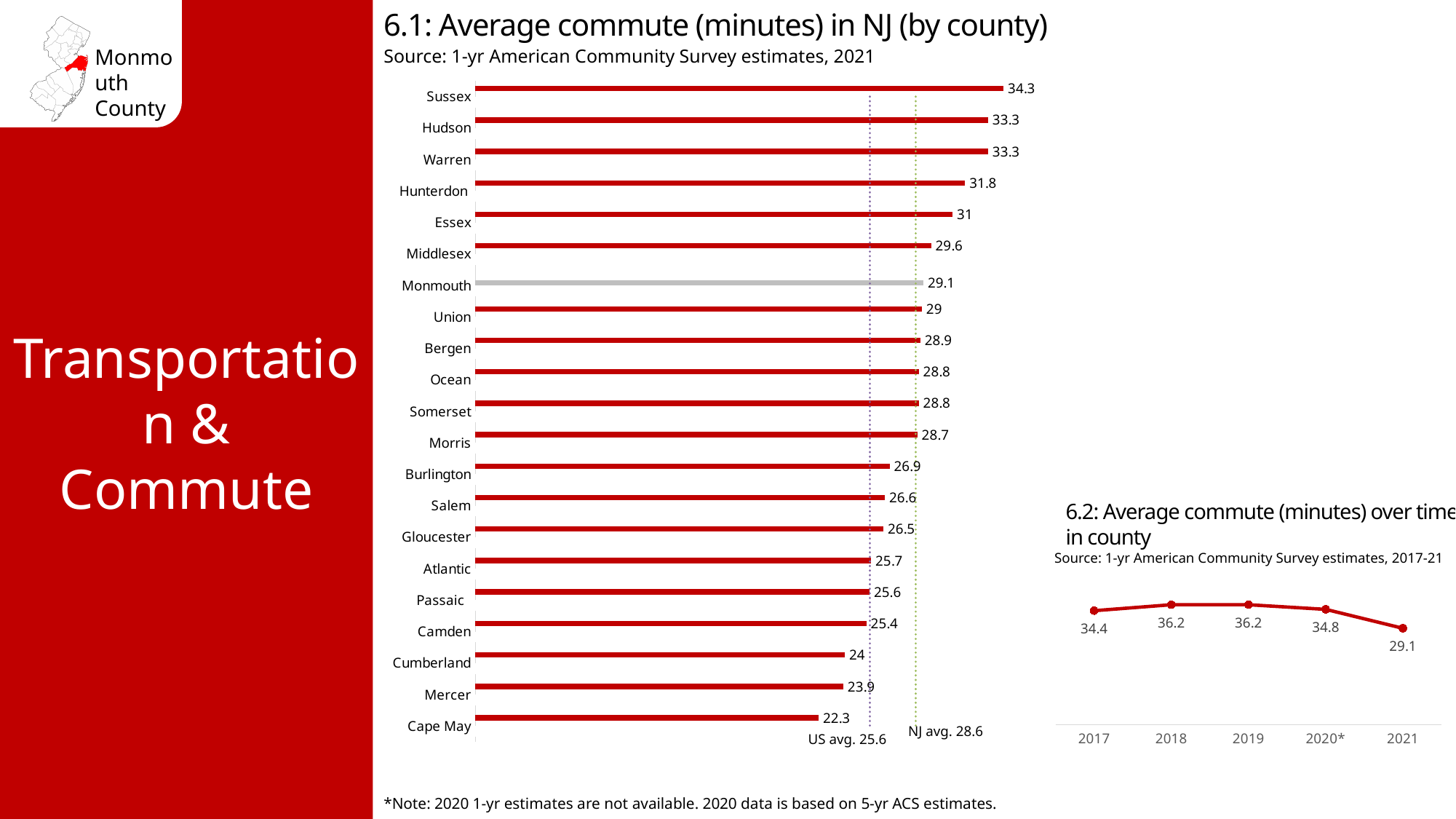
In chart 6.1 (Average commute in NJ by county), what is the average commute for Monmouth? 29.1 In chart 6.1 (Average commute in NJ by county), what is the difference between the average commute for Sussex and Cape May? 12 What kind of chart is chart 6.2 (Average commute over time in county)? Line chart In chart 6.2 (Average commute over time in county), which year has the lowest average commute? 2021 In chart 6.1 (Average commute in NJ by county), which county has the lowest average commute? Cape May In chart 6.2 (Average commute over time in county), what is the difference between the 2017 and 2021 values? 5.3 In chart 6.2 (Average commute over time in county), what is the average commute for 2019? 36.2 In chart 6.1 (Average commute in NJ by county), which county has the highest average commute? Sussex In chart 6.1 (Average commute in NJ by county), what is the NJ average commute shown by the dotted reference line? 28.6 In chart 6.1 (Average commute in NJ by county), how many counties are plotted? 21 What kind of chart is chart 6.1 (Average commute in NJ by county)? Bar chart In chart 6.1 (Average commute in NJ by county), which has a longer average commute, Hunterdon or Burlington? Hunterdon